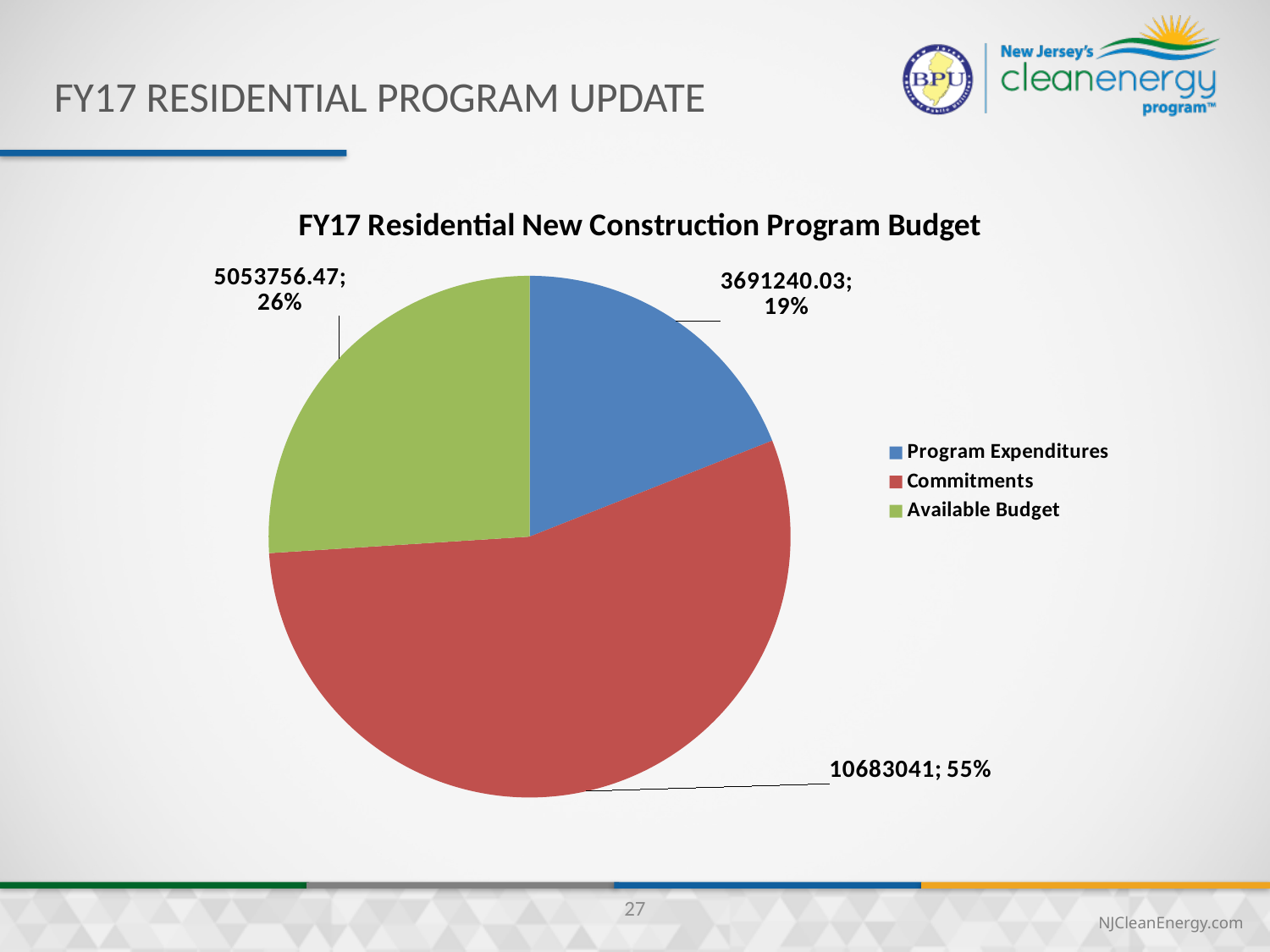
Which category has the smallest slice? Program Expenditures What is the value for Available Budget? 5053756.47 What is the value for Program Expenditures? 3691240.03 Which is larger, Available Budget or Program Expenditures? Available Budget What share of the pie does Commitments represent? 55% What share of the pie does Available Budget represent? 26% What is the title of the chart? FY17 Residential New Construction Program Budget Which category has the largest slice? Commitments What share of the pie does Program Expenditures represent? 19% What is the value for Commitments? 10683041 How many categories does the legend list? 3 What type of chart is shown on the slide? pie chart